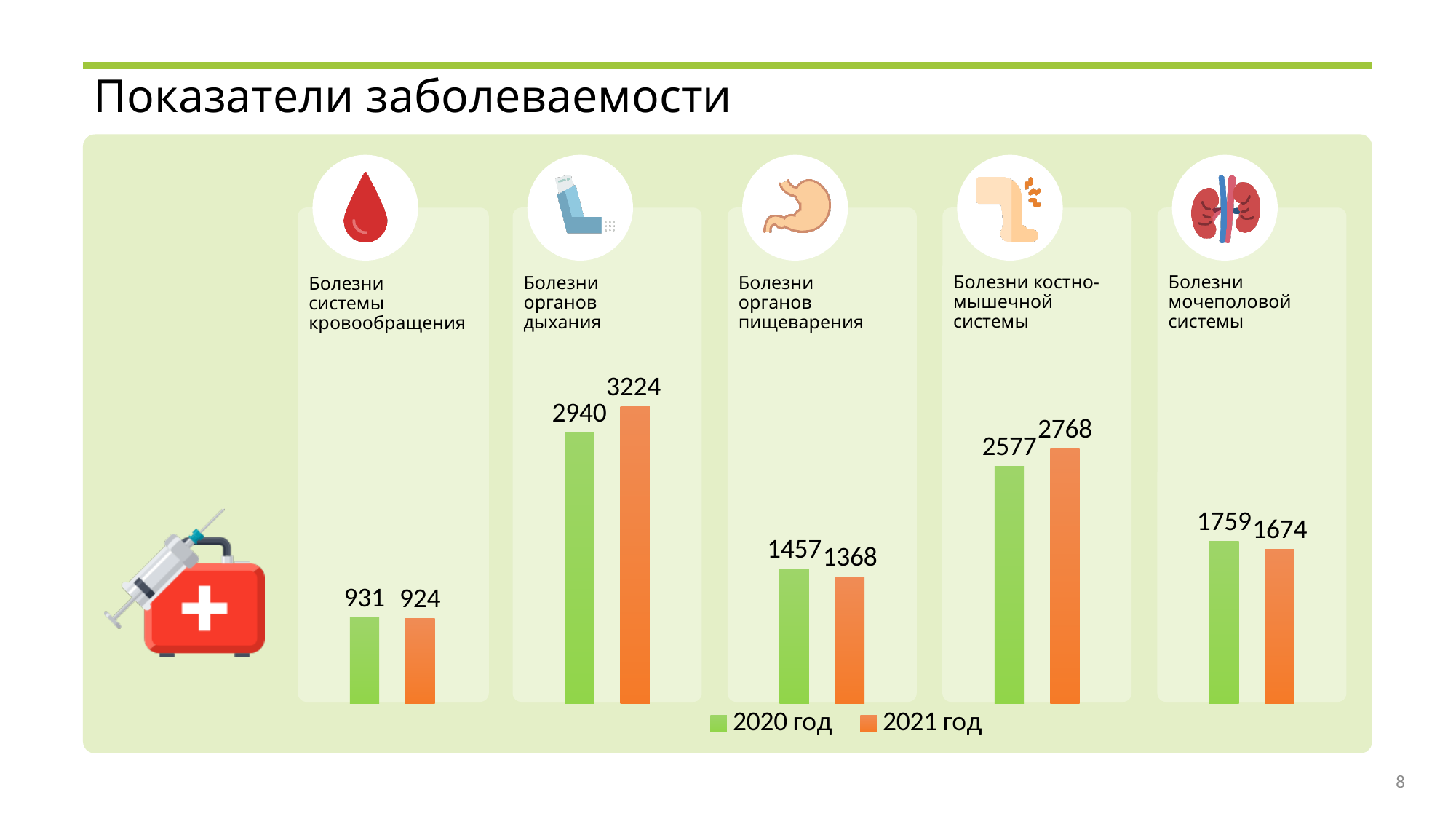
How many series does the legend list? 2 What is the difference between the 2021 год and 2020 год values for Болезни органов дыхания? 284 Which colour represents 2021 год in the chart? Orange Which category has the lowest value in 2020 год? Болезни системы кровообращения Which is larger for Болезни костно-мышечной системы: the 2020 год value or the 2021 год value? 2021 год Which category has the highest value in 2021 год? Болезни органов дыхания What kind of chart is shown on the slide? Bar chart What is the value for Болезни системы кровообращения in 2021 год? 924 What is the value for Болезни органов дыхания in 2020 год? 2940 What is the difference between the 2020 год and 2021 год values for Болезни органов пищеварения? 89 What is the value for Болезни мочеполовой системы in 2021 год? 1674 How many disease categories are shown in the chart? 5